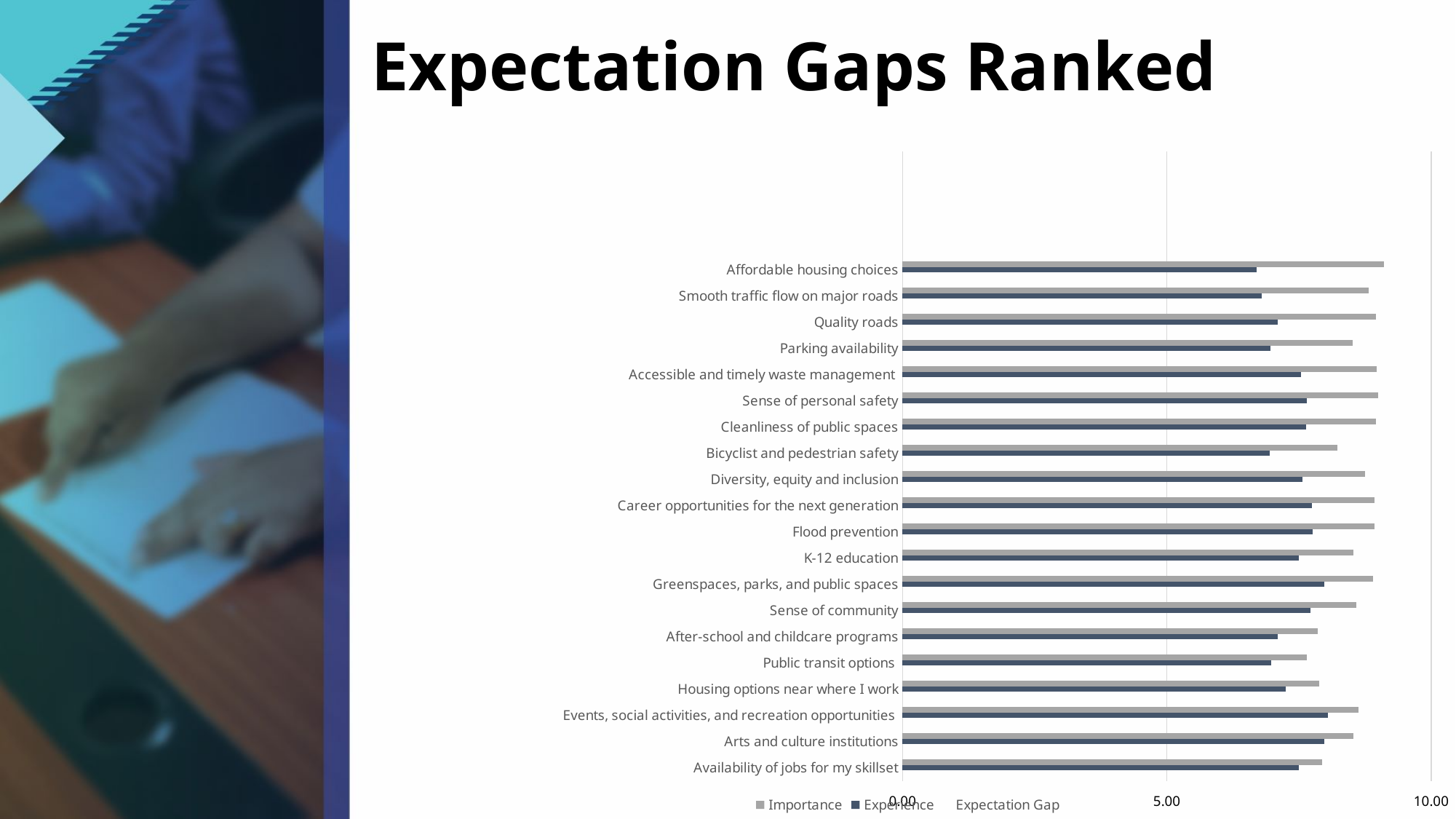
Which has the larger Experience value: Events, social activities, and recreation opportunities or Affordable housing choices? Events, social activities, and recreation opportunities For Affordable housing choices, which is larger: the Importance value or the Experience value? Importance How many series does the chart legend list? 3 Is the Importance value for Affordable housing choices greater or less than 5.00? greater How many categories are plotted on the chart? 20 Is the Experience value for Public transit options greater or less than 5.00? greater Which category is listed first (at the top) of the chart? Affordable housing choices Which has the larger Importance value: Affordable housing choices or Public transit options? Affordable housing choices Is the Importance value for Affordable housing choices greater or less than 10.00? less What kind of chart is shown on the slide? bar chart What is the title of the slide containing the chart? Expectation Gaps Ranked